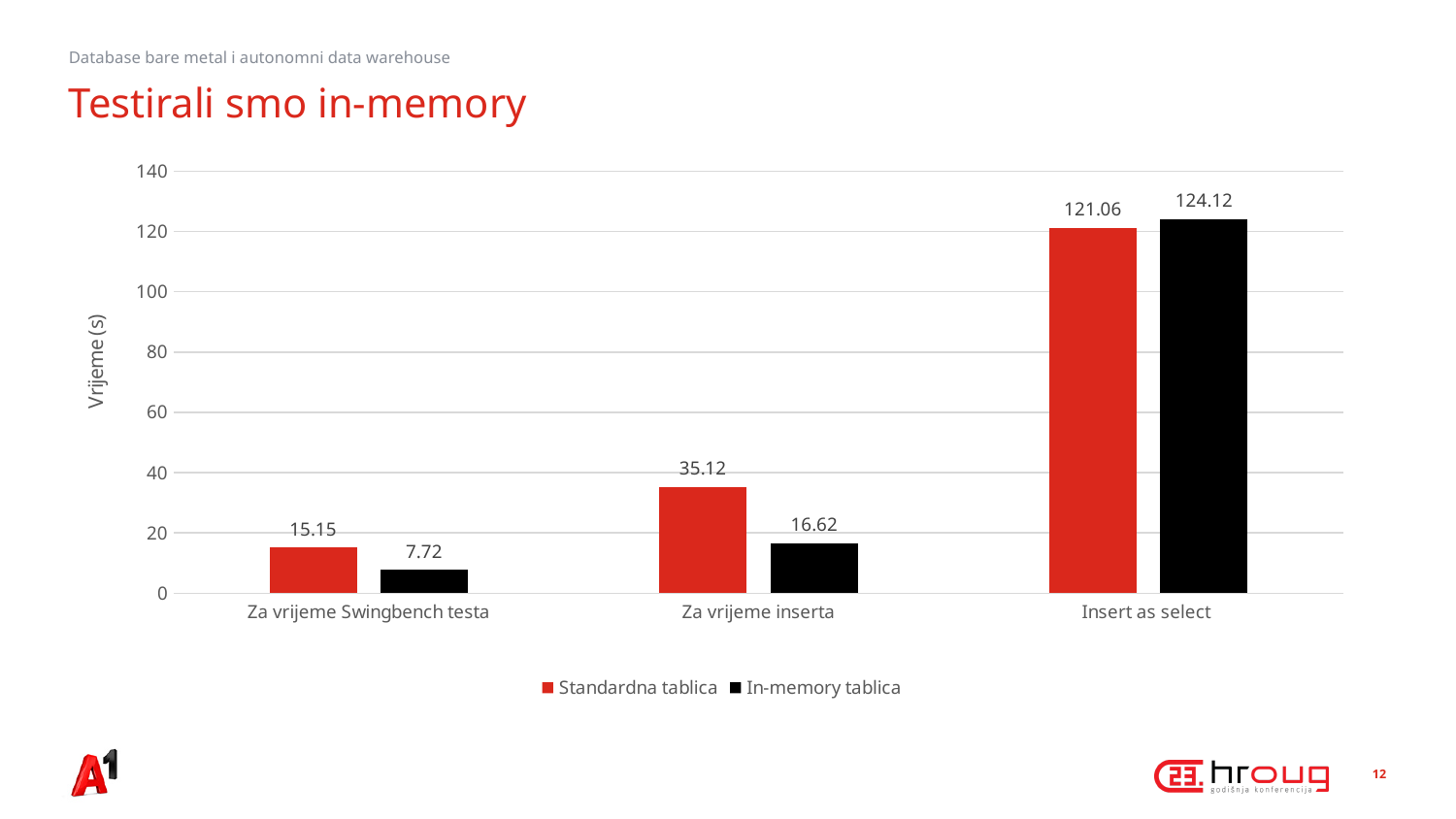
What is the value for Standardna tablica in the Za vrijeme Swingbench testa category? 15.15 Which category has the lowest value for In-memory tablica? Za vrijeme Swingbench testa What is the difference between Standardna tablica and In-memory tablica in the Za vrijeme inserta category? 18.5 Is the value for Standardna tablica in the Insert as select category greater or less than 100? greater What kind of chart is shown on the slide? Bar chart How many series does the legend list? 2 How many categories are shown on the x axis? 3 What is the value for In-memory tablica in the Insert as select category? 124.12 Which category has the highest value for Standardna tablica? Insert as select What is the label of the y axis? Vrijeme (s) In the Insert as select category, which series has the larger value, Standardna tablica or In-memory tablica? In-memory tablica What is the value for In-memory tablica in the Za vrijeme inserta category? 16.62